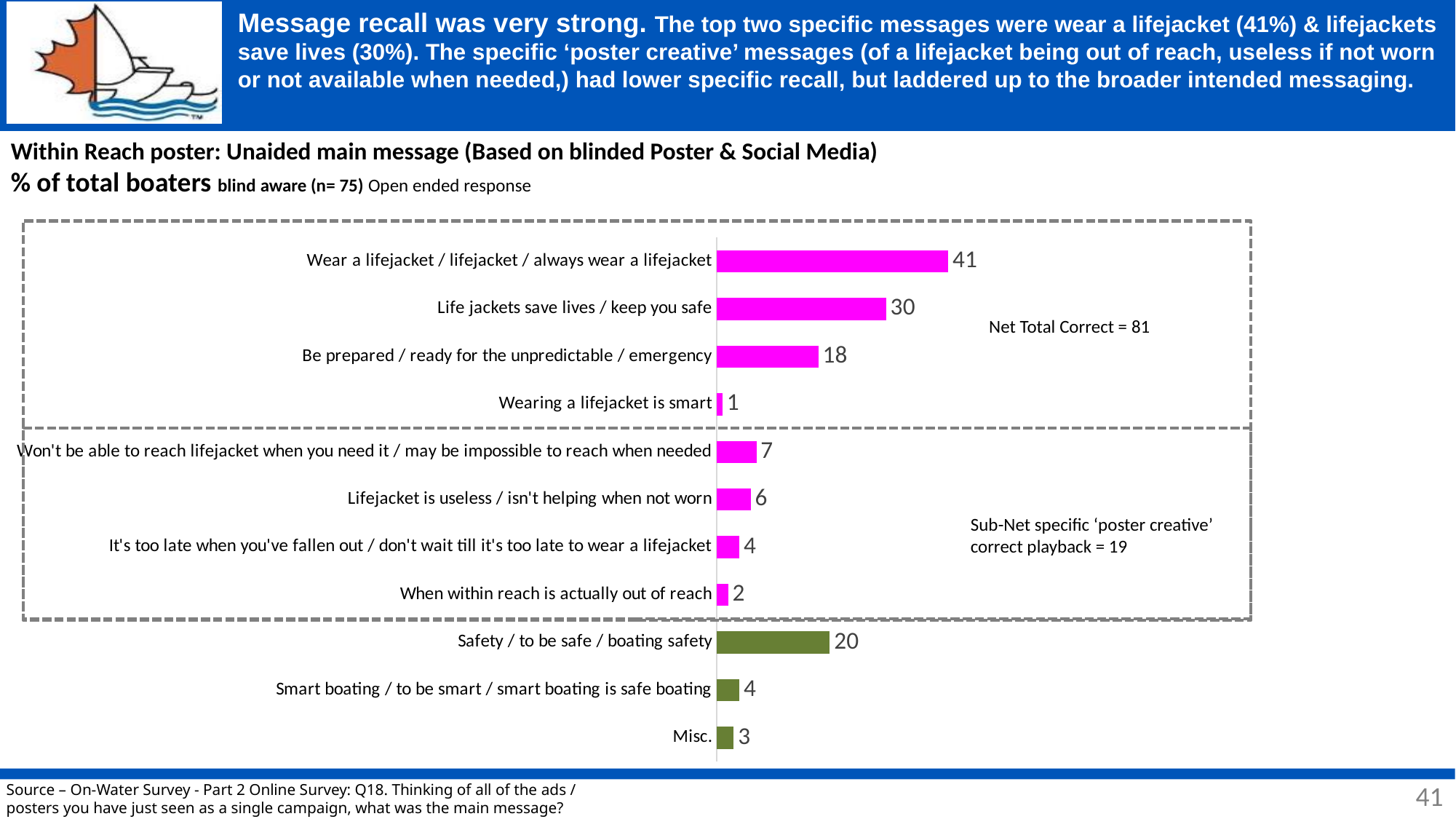
Which category has the lowest value? Wearing a lifejacket is smart What kind of chart is shown on the slide? Bar chart Which category has the highest value? Wear a lifejacket / lifejacket / always wear a lifejacket How many categories are shown in the chart? 11 What is the difference between the values for "Wear a lifejacket / lifejacket / always wear a lifejacket" and "Life jackets save lives / keep you safe"? 11 What is the value for "Lifejacket is useless / isn't helping when not worn"? 6 What is the value for "Safety / to be safe / boating safety"? 20 What is the Net Total Correct value shown on the chart? 81 What is the value for "Wear a lifejacket / lifejacket / always wear a lifejacket"? 41 What is the Sub-Net specific 'poster creative' correct playback value shown on the chart? 19 What is the value for "Be prepared / ready for the unpredictable / emergency"? 18 Which is larger: the value for "Safety / to be safe / boating safety" or the value for "Be prepared / ready for the unpredictable / emergency"? Safety / to be safe / boating safety